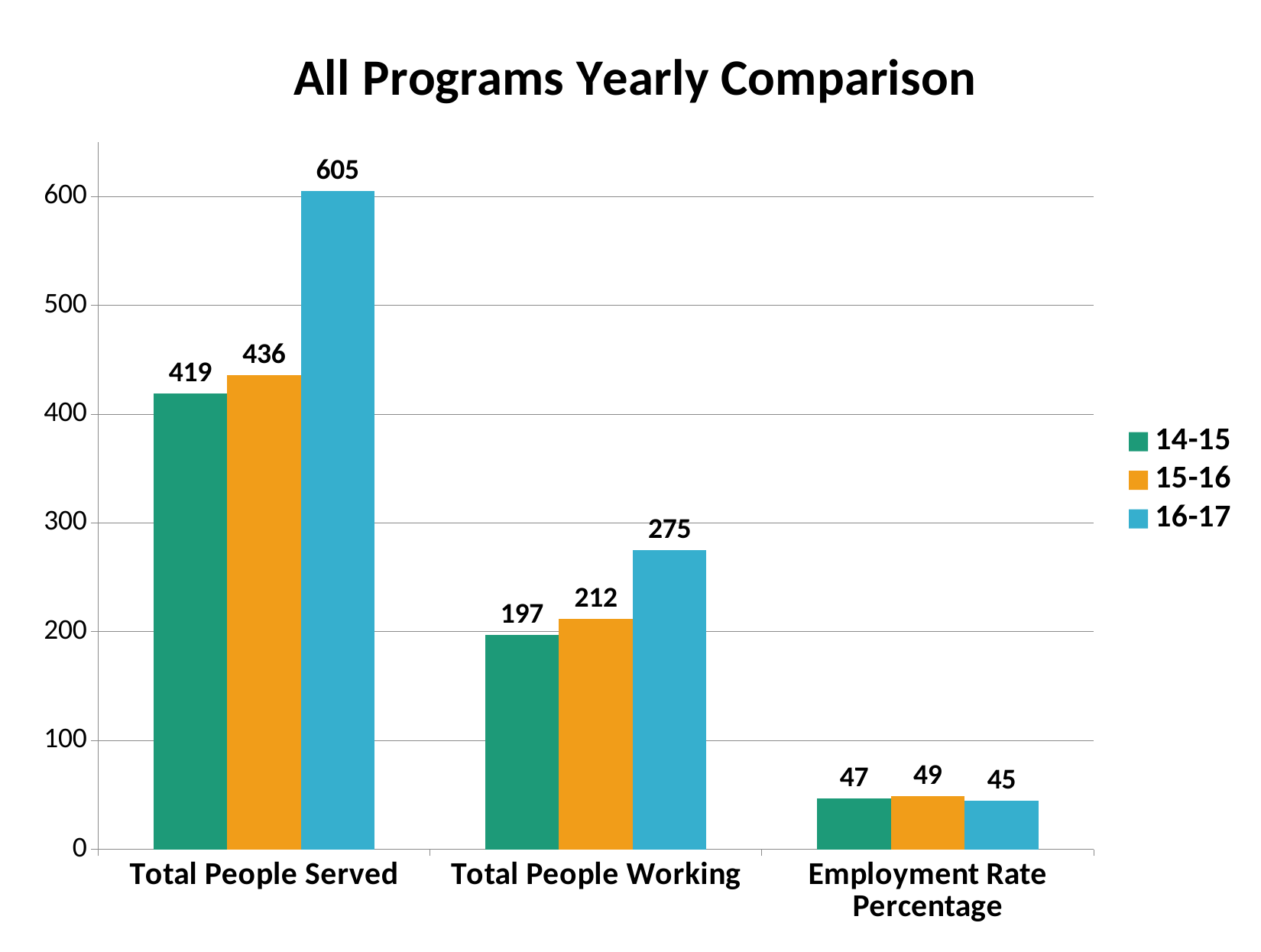
Which is larger: Total People Served in 14-15 or Total People Working in 16-17? Total People Served in 14-15 What is the Employment Rate Percentage for 15-16? 49 How many categories are shown on the x axis? 3 What kind of chart is shown on the slide? Bar chart Which year has the highest value for Total People Served? 16-17 What is the difference between Total People Working in 16-17 and 14-15? 78 What is the difference between Total People Served in 16-17 and 15-16? 169 Which year has the lowest value for Total People Working? 14-15 How many series does the legend list? 3 What is the value for Total People Working in 14-15? 197 What is the value for Total People Served in 16-17? 605 Is the value for Total People Working in 15-16 greater or less than 200? greater